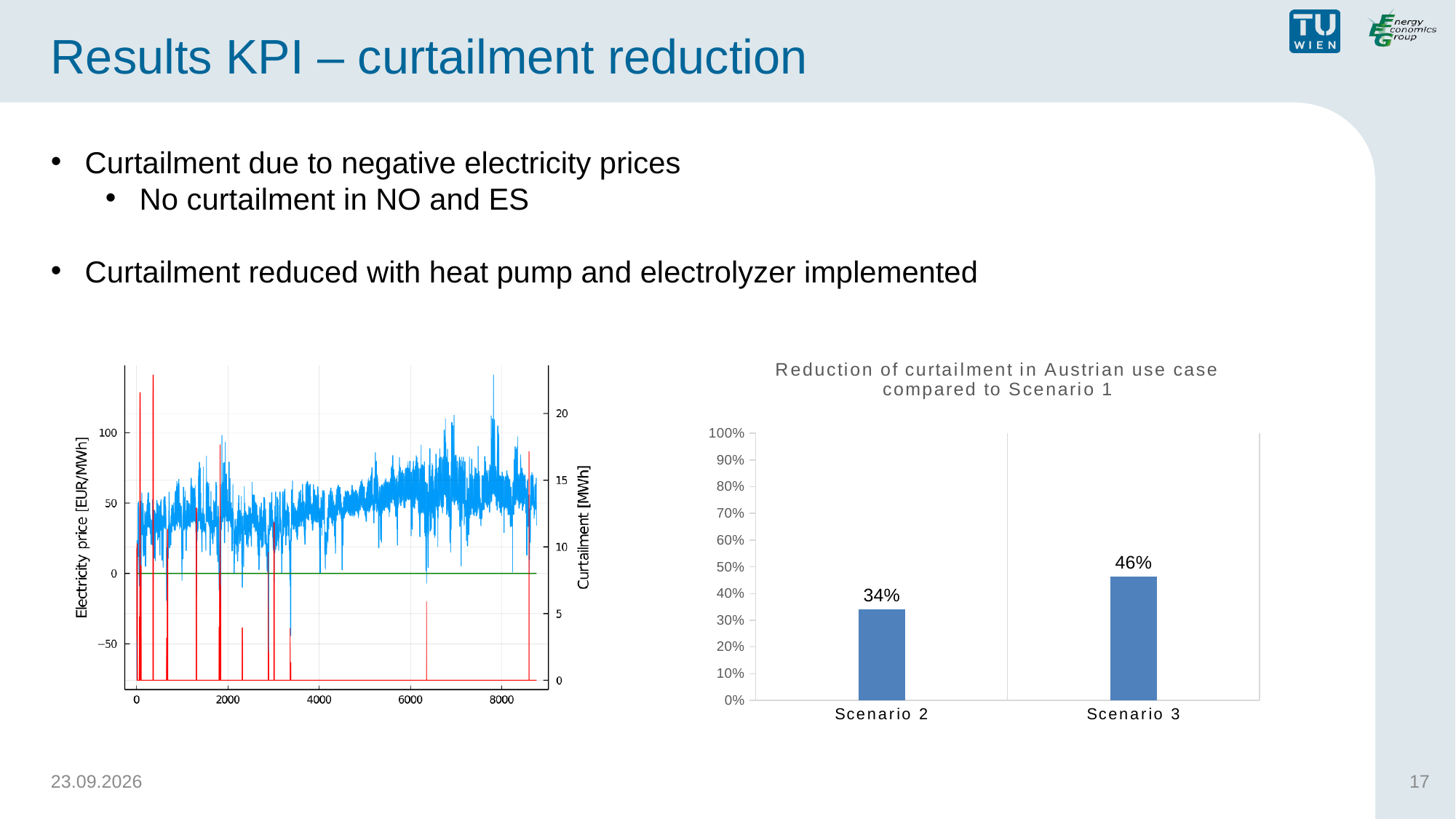
What kind of chart is the chart titled "Reduction of curtailment in Austrian use case compared to Scenario 1"? bar chart In the chart titled "Reduction of curtailment in Austrian use case compared to Scenario 1", what is the value for Scenario 3? 46% In the chart on the left of the slide, what is the label of the right-hand y axis? Curtailment [MWh] In the chart titled "Reduction of curtailment in Austrian use case compared to Scenario 1", is the value for Scenario 3 greater or less than 40%? greater In the chart titled "Reduction of curtailment in Austrian use case compared to Scenario 1", is the value for Scenario 2 or Scenario 3 larger? Scenario 3 In the chart titled "Reduction of curtailment in Austrian use case compared to Scenario 1", how many scenarios are plotted? 2 In the chart titled "Reduction of curtailment in Austrian use case compared to Scenario 1", what is the difference between the values for Scenario 3 and Scenario 2? 12% In the chart titled "Reduction of curtailment in Austrian use case compared to Scenario 1", which scenario has the highest value? Scenario 3 In the chart titled "Reduction of curtailment in Austrian use case compared to Scenario 1", which scenario has the lowest value? Scenario 2 In the chart titled "Reduction of curtailment in Austrian use case compared to Scenario 1", what is the value for Scenario 2? 34% In the chart titled "Reduction of curtailment in Austrian use case compared to Scenario 1", is the value for Scenario 2 greater or less than 40%? less What kind of chart is the chart on the left of the slide? line chart